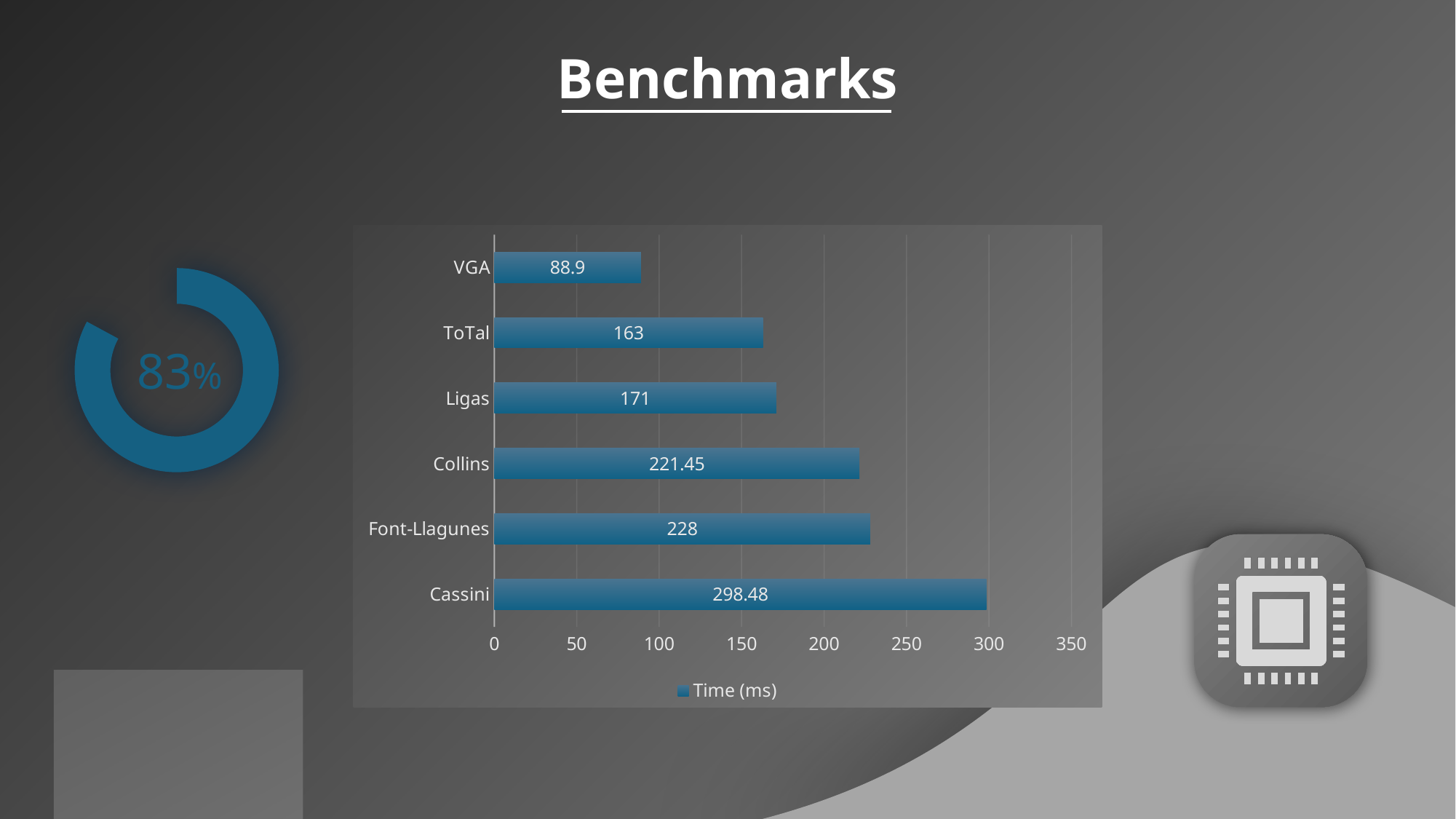
In the bar chart, what is the difference in Time (ms) between Cassini and VGA? 209.58 In the bar chart, which category has the highest Time (ms)? Cassini What series name does the legend of the bar chart show? Time (ms) In the bar chart, what is the Time (ms) value for VGA? 88.9 How many categories are shown in the bar chart? 6 What kind of chart is used to show the Time (ms) values? bar chart In the bar chart, what is the difference in Time (ms) between Font-Llagunes and Ligas? 57 In the bar chart, what is the Time (ms) value for Cassini? 298.48 In the bar chart, which category has the lowest Time (ms)? VGA In the bar chart, what is the Time (ms) value for Collins? 221.45 In the bar chart, which has a larger Time (ms), Collins or ToTal? Collins In the bar chart, is the value for Ligas greater or less than 200? less